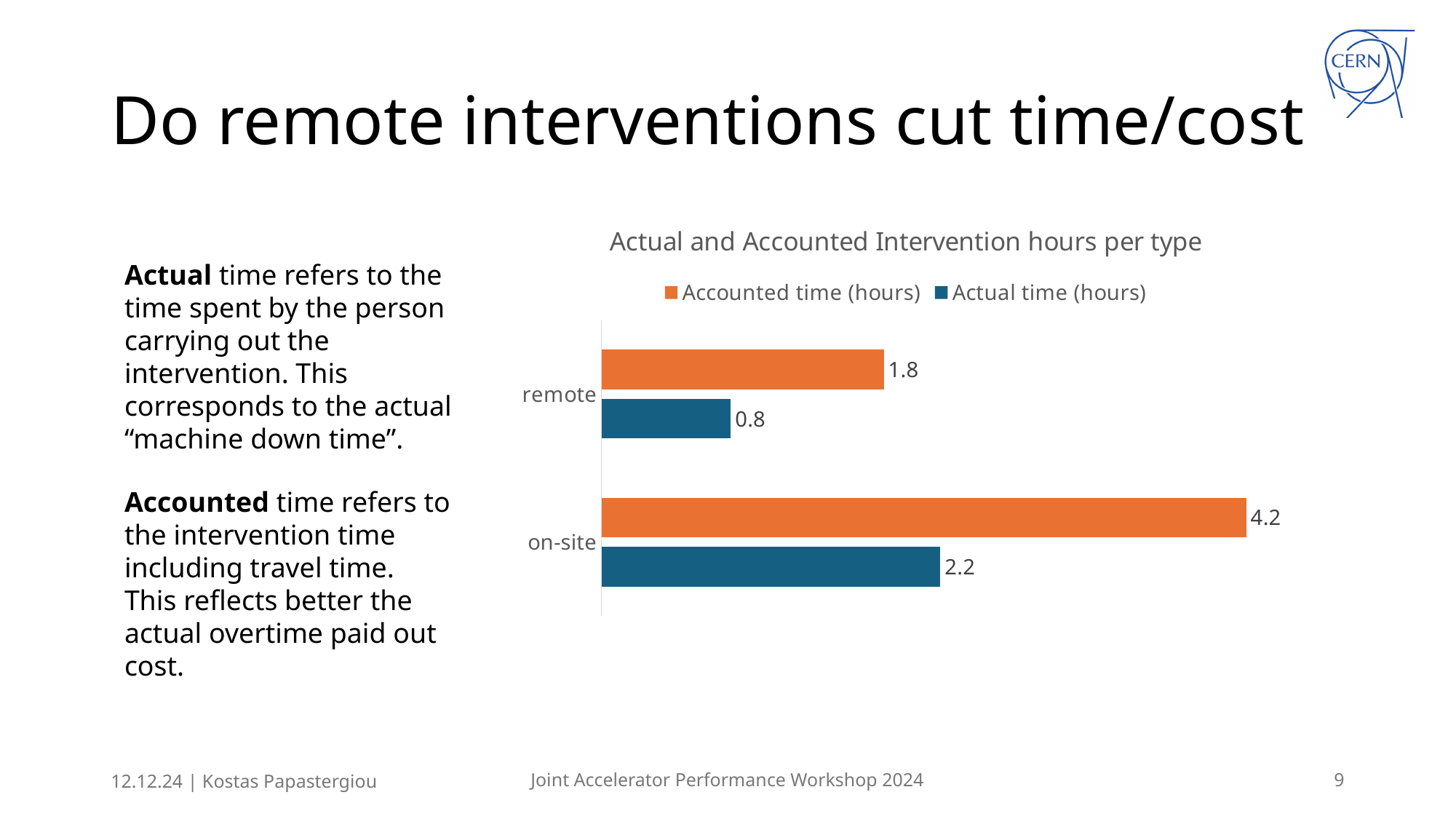
What is the difference in Accounted time (hours) between on-site and remote interventions? 2.4 What is the Actual time (hours) for remote interventions? 0.8 Which is larger: the Actual time for on-site or the Accounted time for remote? Actual time for on-site What is the difference between the Accounted time and the Actual time for on-site interventions? 2.0 What is the Accounted time (hours) for remote interventions? 1.8 What is the title of the chart? Actual and Accounted Intervention hours per type Which category has the lowest Actual time (hours)? remote Which category has the highest Accounted time (hours)? on-site What kind of chart is shown on the slide? bar chart What is the Actual time (hours) for on-site interventions? 2.2 How many intervention types are shown on the chart? 2 How many series does the legend list? 2